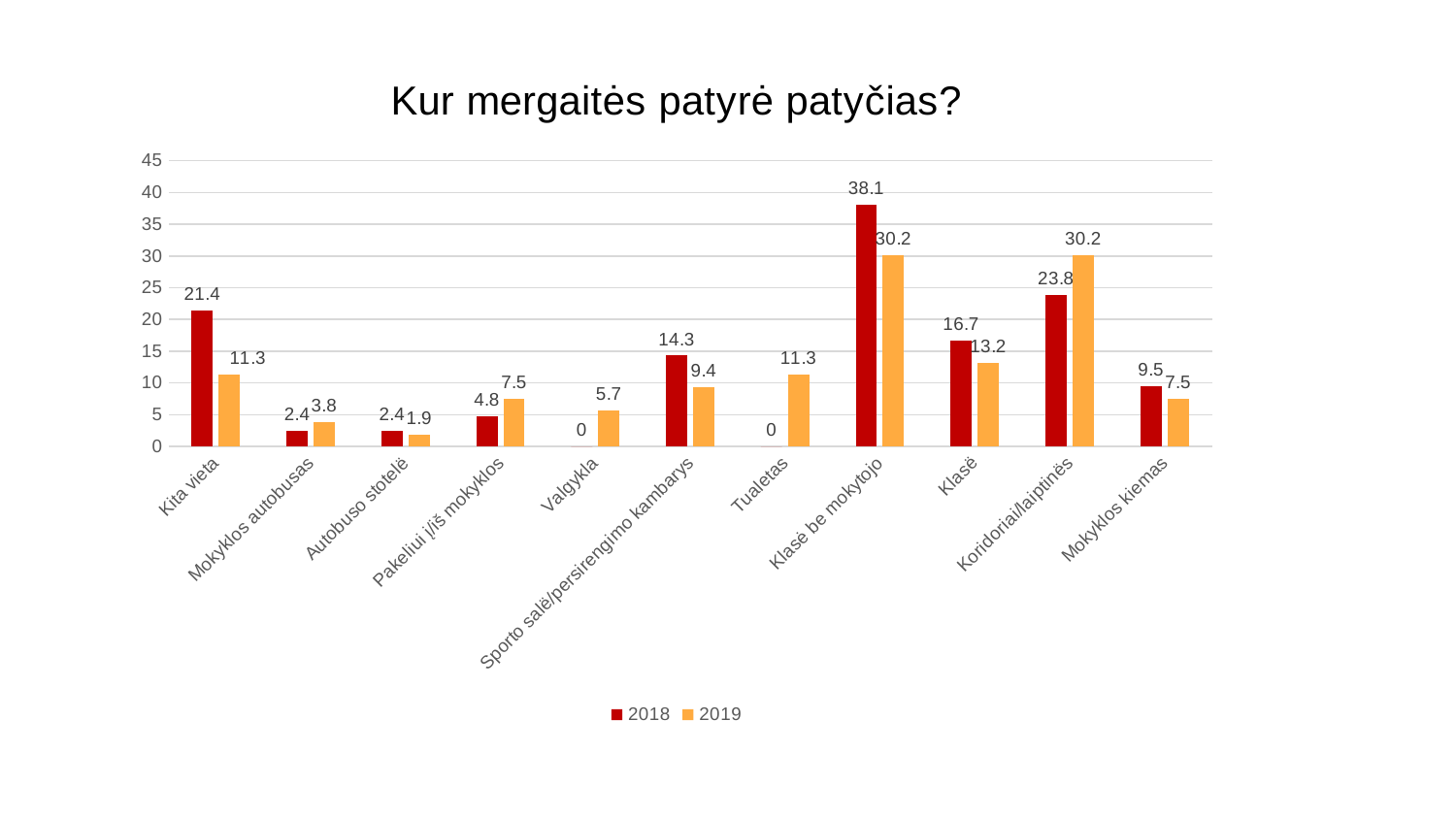
What kind of chart is shown on the slide? Bar chart How many categories are shown on the x axis? 11 What is the 2019 value for Koridoriai/laiptinės? 30.2 Which is larger for Koridoriai/laiptinės, the 2018 value or the 2019 value? 2019 What is the difference between the 2018 and 2019 values for Kita vieta? 10.1 How many series does the legend list? 2 Which category has the highest 2018 value? Klasė be mokytojo What is the 2019 value for Tualetas? 11.3 What is the 2018 value for Klasė be mokytojo? 38.1 What is the title of the chart? Kur mergaitės patyrė patyčias? Which is larger for Klasė, the 2018 value or the 2019 value? 2018 Which category has the lowest 2019 value? Autobuso stotelė